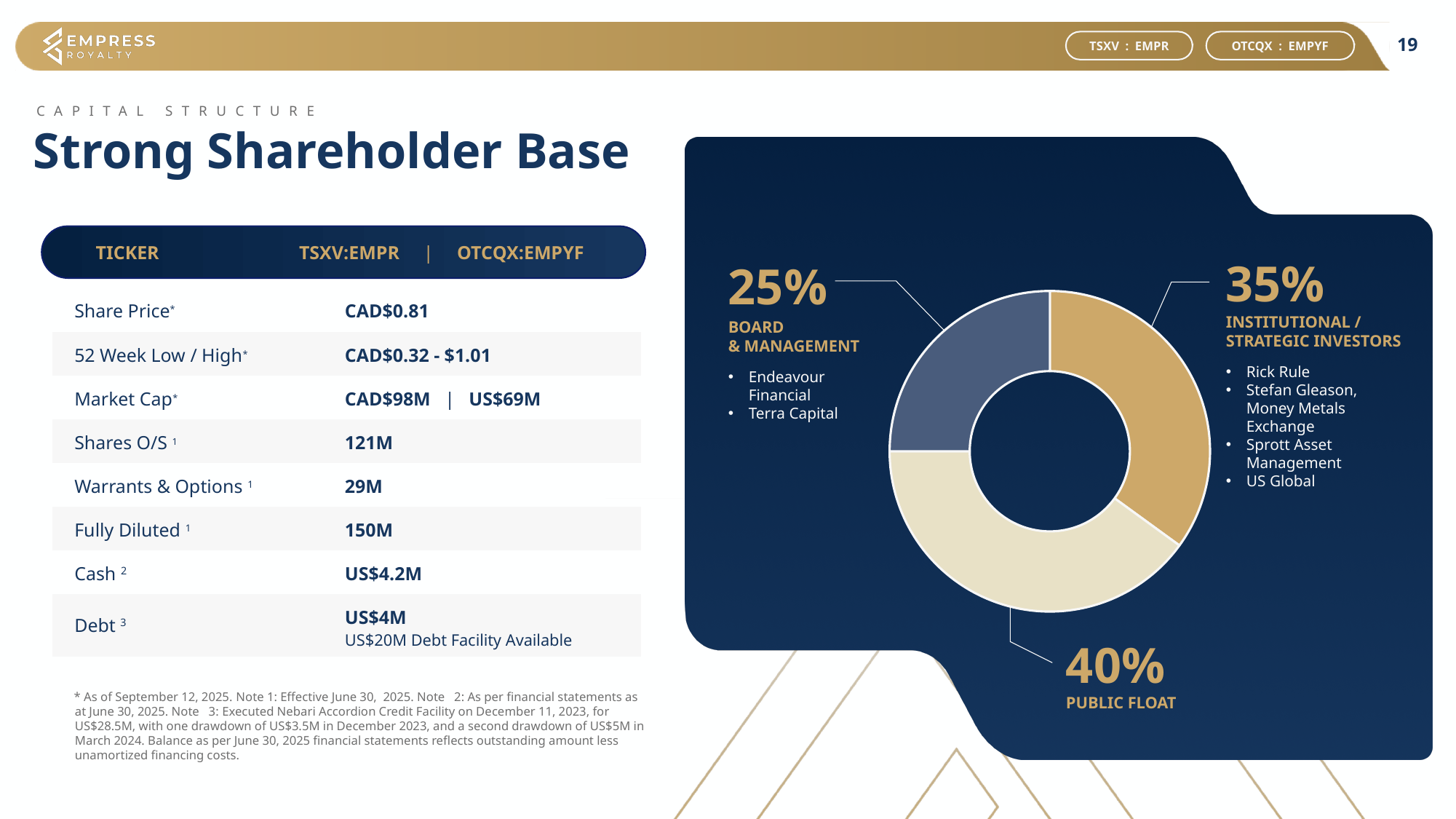
Which segment of the donut chart is the smallest? Board & Management What share of the shareholder base is the Public Float? 40% What is the difference in percentage points between Institutional / Strategic Investors and Board & Management? 10 Which segment of the donut chart is coloured gold? Institutional / Strategic Investors What share of the shareholder base is held by Board & Management? 25% What is the combined share of Board & Management and Institutional / Strategic Investors? 60% What is the difference in percentage points between the Public Float and Board & Management shares? 15 What kind of chart is shown on the slide? Donut (pie) chart Which is larger: the Institutional / Strategic Investors share or the Board & Management share? Institutional / Strategic Investors Which segment of the donut chart is the largest? Public Float How many segments does the donut chart have? 3 What share of the shareholder base is held by Institutional / Strategic Investors? 35%